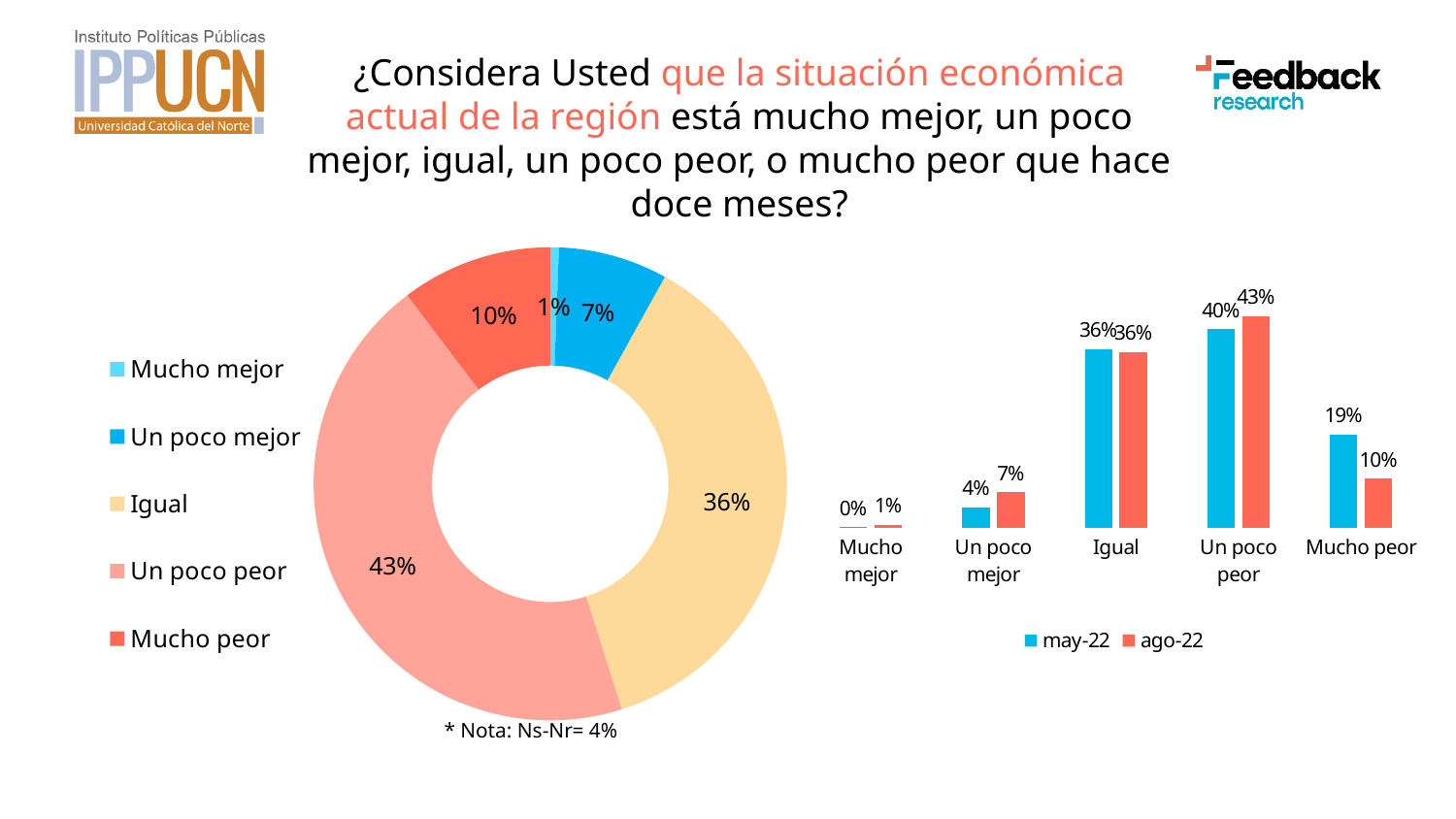
In the bar chart on the right, what is the value for 'Mucho peor' in ago-22? 10% In the donut chart on the left, which category has the smallest share? Mucho mejor In the bar chart on the right, what is the value for 'Igual' in may-22? 36% In the bar chart on the right, which is larger for 'Un poco mejor': may-22 or ago-22? ago-22 In the bar chart on the right, what is the difference between the may-22 and ago-22 values for 'Mucho peor'? 9% In the bar chart on the right, what is the value for 'Un poco peor' in may-22? 40% In the donut chart on the left, which category has the largest share? Un poco peor What kind of chart is the chart on the left of the slide? Donut (pie) chart In the bar chart on the right, which category has the highest ago-22 value? Un poco peor In the donut chart on the left, how many categories does the legend list? 5 In the donut chart on the left, what share is labelled for 'Un poco peor'? 43% In the bar chart on the right, how many series does the legend list? 2